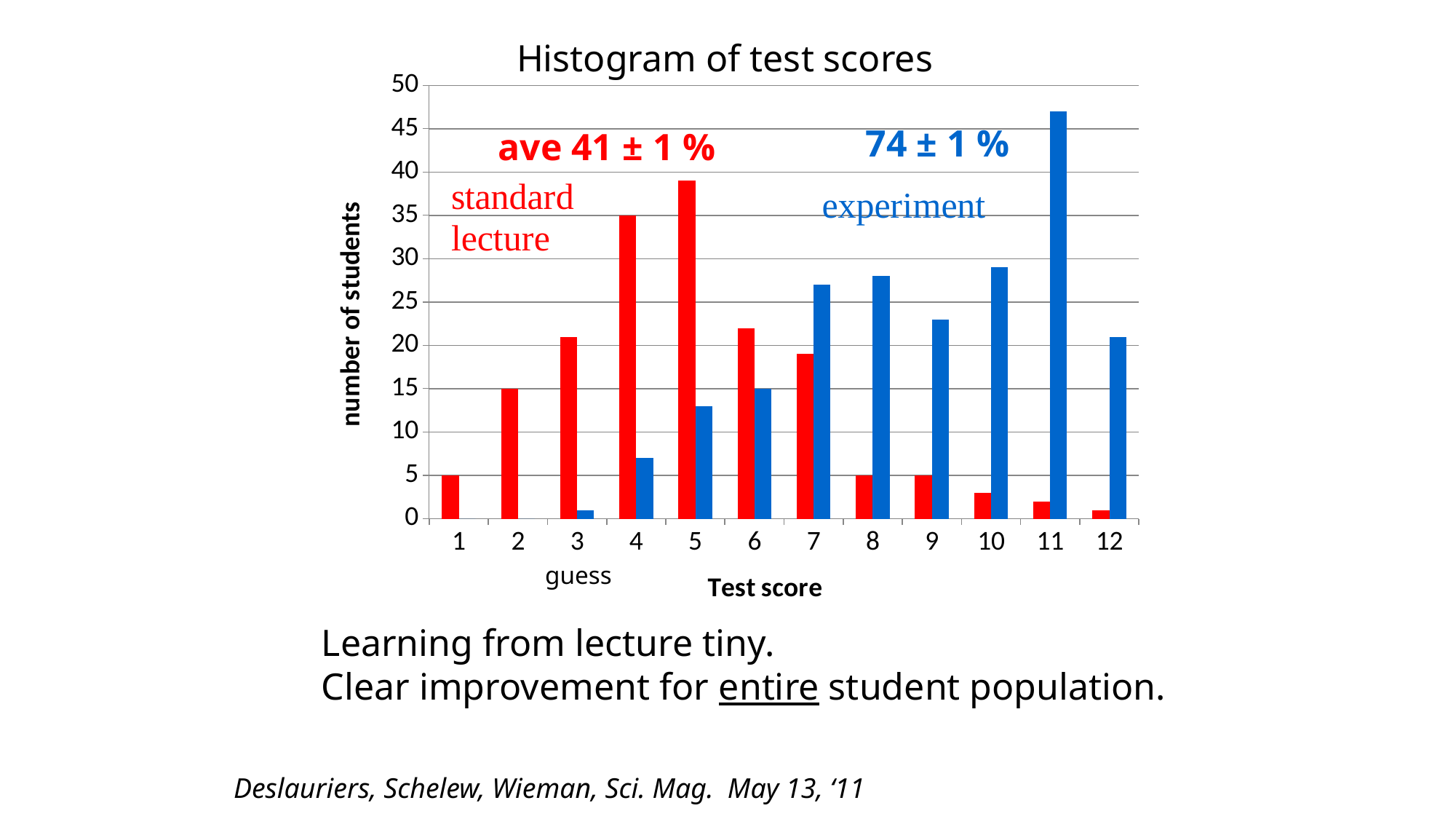
How many students in the standard lecture group scored 2? 15 What kind of chart is shown on the slide? bar chart What is the difference between the number of standard lecture students scoring 4 and those scoring 2? 20 Is the number of experiment students scoring 11 greater or less than 45? greater What is the title of the chart? Histogram of test scores How many students in the experiment group scored 6? 15 At test score 7, which group has more students, standard lecture or experiment? experiment At which test score is the standard lecture group's bar highest? 5 How many test score categories are shown on the x axis? 12 At which test score is the experiment group's bar highest? 11 How many students in the standard lecture group scored 4? 35 How many data series are plotted in the chart? 2